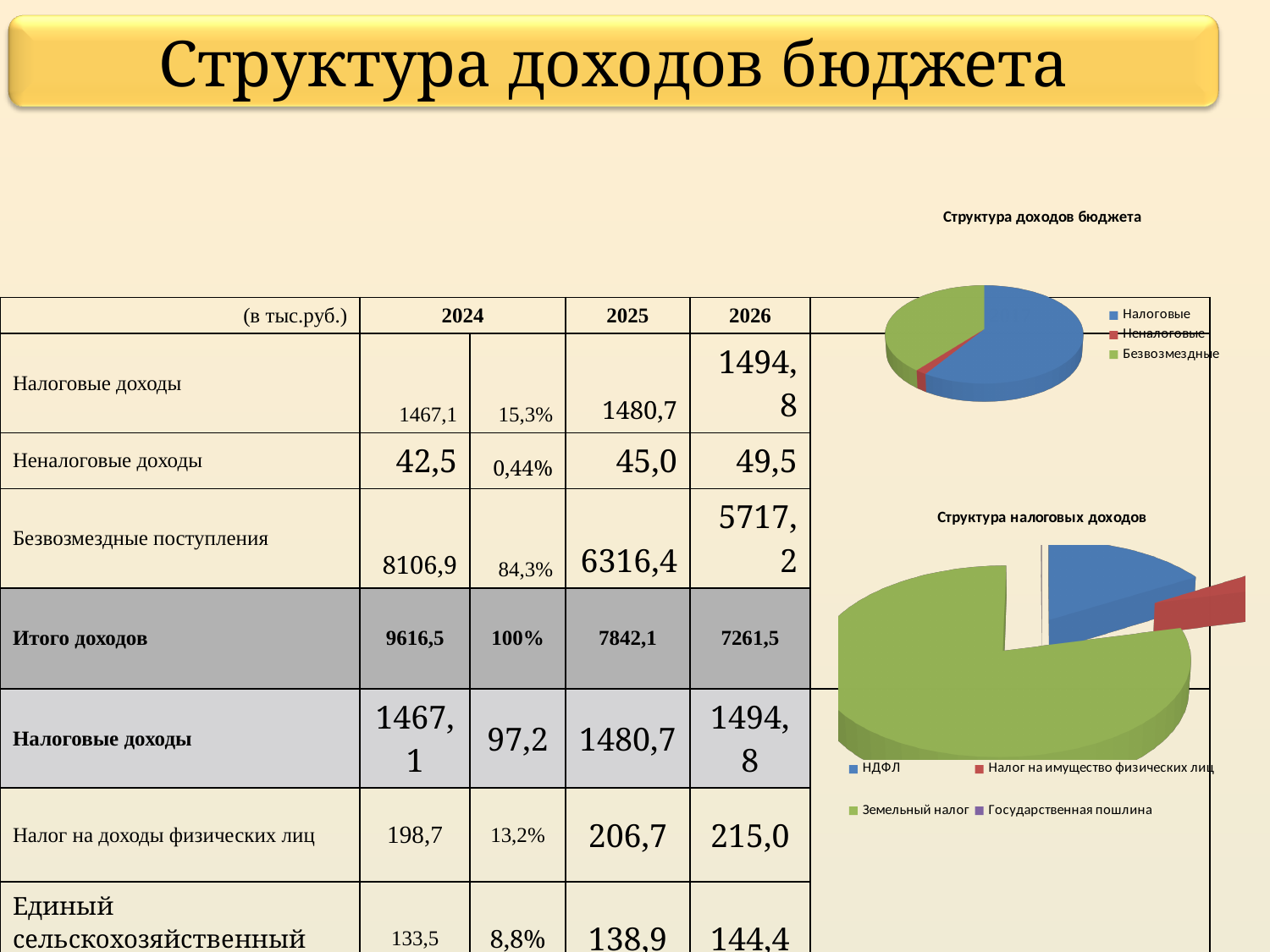
In the bottom chart "Структура налоговых доходов", which category has the largest slice? Земельный налог In the bottom chart "Структура налоговых доходов", how many categories does the legend list? 4 What kind of chart is the bottom chart titled "Структура налоговых доходов"? pie chart In the bottom chart "Структура налоговых доходов", which category is shown in red? Налог на имущество физических лиц What kind of chart is the top chart titled "Структура доходов бюджета"? pie chart In the bottom chart "Структура налоговых доходов", which slice is larger: Земельный налог or НДФЛ? Земельный налог In the top chart "Структура доходов бюджета", what colour is the Безвозмездные slice? green In the top chart "Структура доходов бюджета", which category has the largest slice? Налоговые In the bottom chart "Структура налоговых доходов", which category has the smallest slice? Государственная пошлина In the top chart "Структура доходов бюджета", which category has the smallest slice? Неналоговые In the top chart "Структура доходов бюджета", which slice is larger: Налоговые or Неналоговые? Налоговые In the top chart "Структура доходов бюджета", how many categories does the legend list? 3